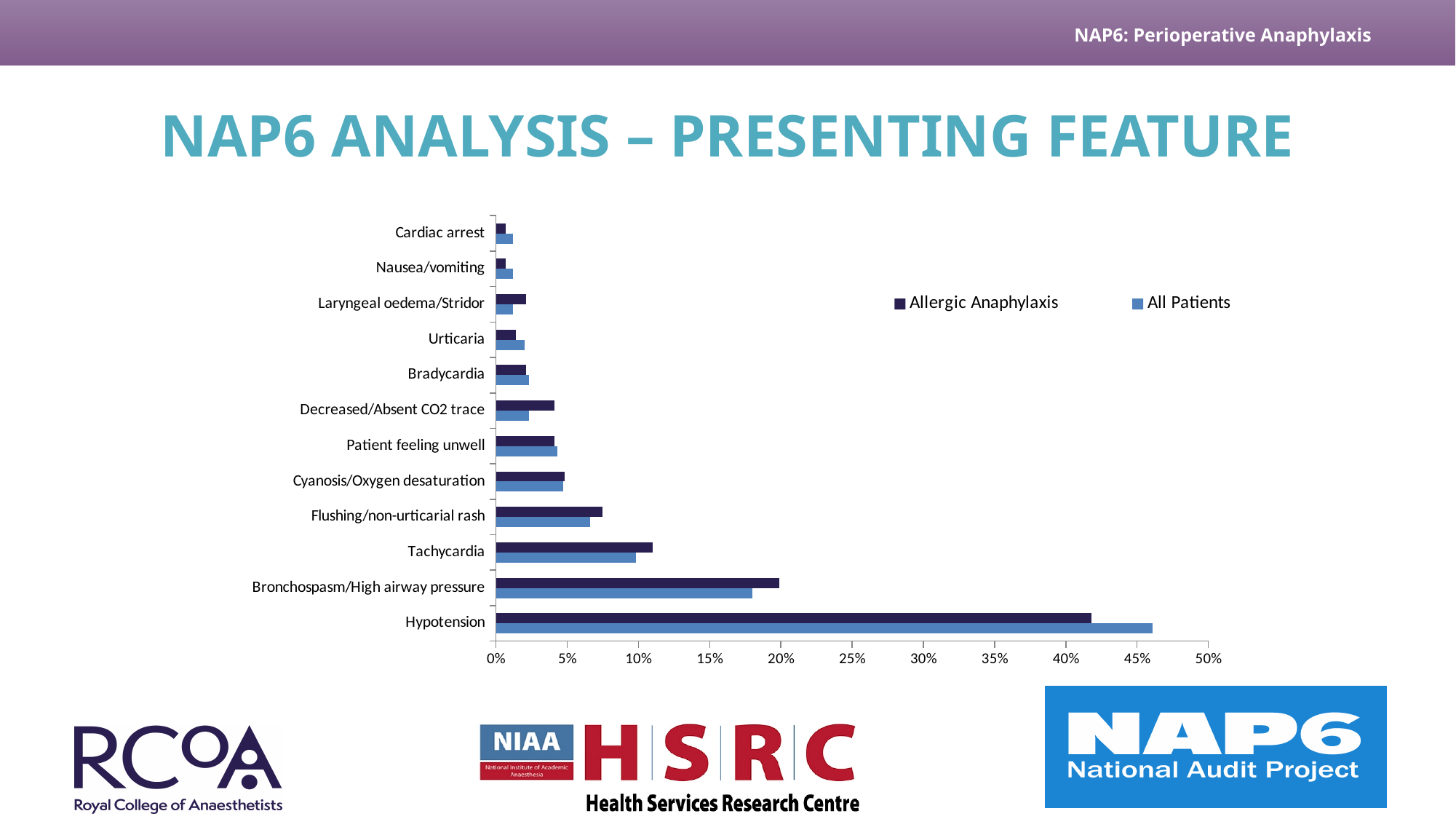
For Decreased/Absent CO2 trace, which series has the larger value: Allergic Anaphylaxis or All Patients? Allergic Anaphylaxis Which presenting feature has the highest value for the All Patients series? Hypotension Is the Allergic Anaphylaxis value for Bronchospasm/High airway pressure greater or less than 15%? greater How many series does the chart legend list? 2 How many presenting feature categories are plotted on the chart? 12 For Hypotension, which series has the larger value: Allergic Anaphylaxis or All Patients? All Patients Which presenting feature has the highest value for the Allergic Anaphylaxis series? Hypotension Is the Allergic Anaphylaxis value for Hypotension greater or less than 40%? greater What kind of chart is shown on the slide? Bar chart Is the Allergic Anaphylaxis value for Flushing/non-urticarial rash greater or less than 5%? greater Which series is shown in the dark navy colour in the legend? Allergic Anaphylaxis